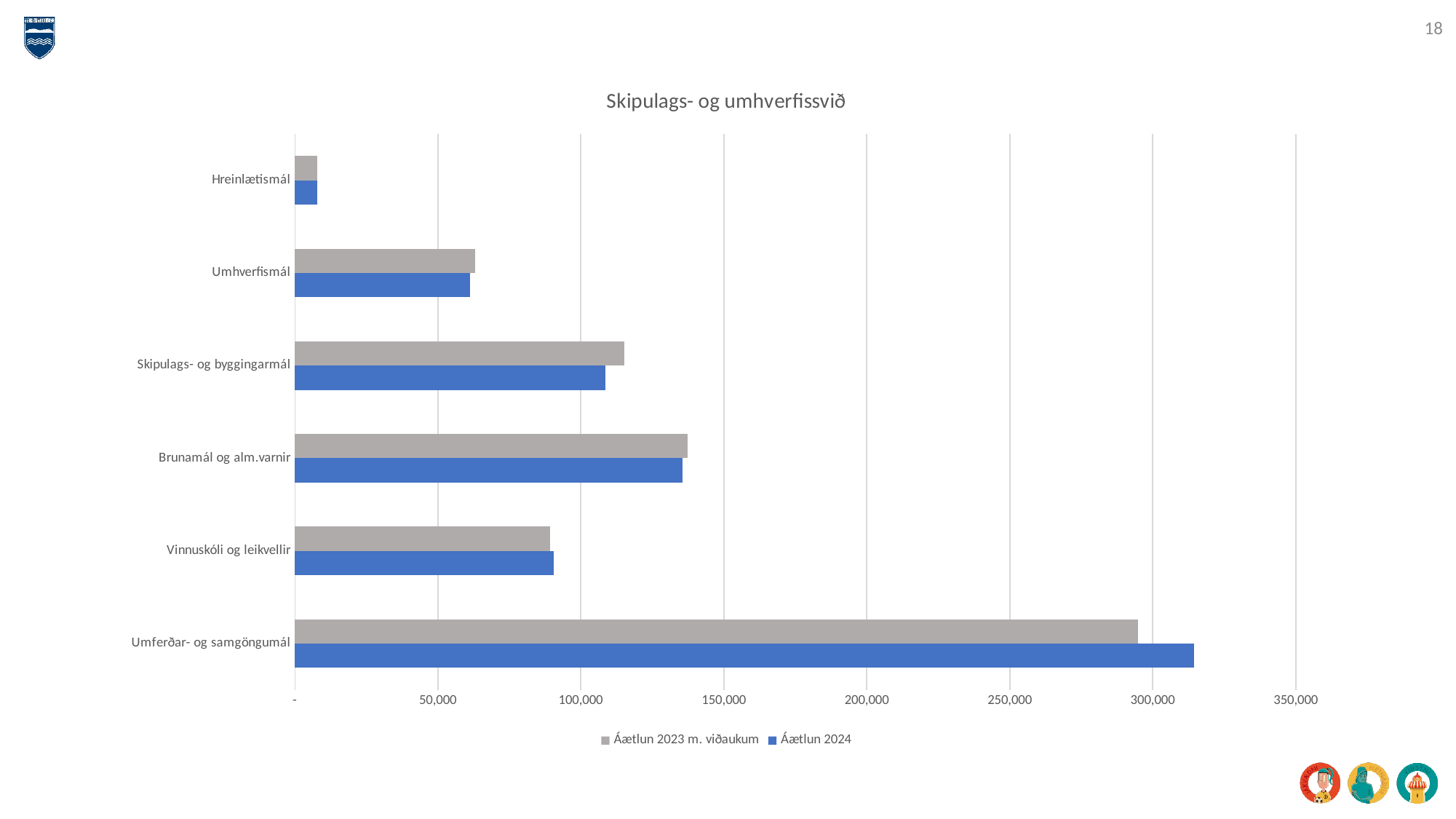
What kind of chart is shown on the slide? bar chart What is the title of the chart? Skipulags- og umhverfissvið Is the Áætlun 2024 value for Umferðar- og samgöngumál greater or less than 300,000? greater Is the Áætlun 2024 value for Skipulags- og byggingarmál greater or less than 100,000? greater For Umferðar- og samgöngumál, which series has the larger value: Áætlun 2023 m. viðaukum or Áætlun 2024? Áætlun 2024 How many series does the legend list? 2 Which category has the highest value for Áætlun 2024? Umferðar- og samgöngumál Is the Áætlun 2023 m. viðaukum value for Vinnuskóli og leikvellir greater or less than 100,000? less How many categories are shown on the chart? 6 Which category has the lowest value for Áætlun 2023 m. viðaukum? Hreinlætismál Which colour represents the Áætlun 2024 series? blue